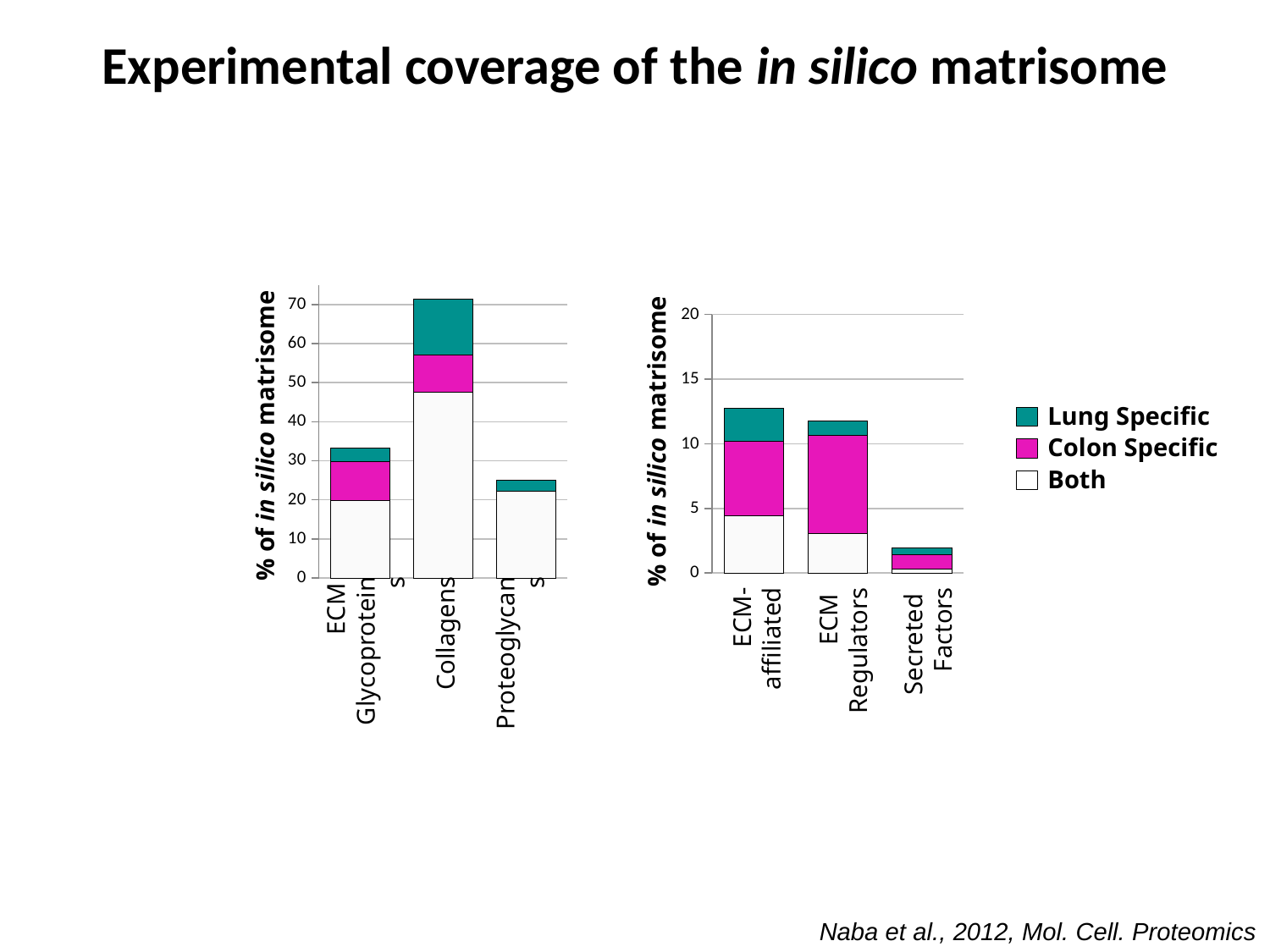
In the left chart, is the total bar for Collagens larger or smaller than the total bar for ECM Glycoproteins? larger In the right chart, which category has the lowest total bar? Secreted Factors In the left chart, is the total value for Proteoglycans greater or less than 30? less In the left chart, is the total value for Collagens greater or less than 60? greater In the right chart, is the total value for ECM Regulators greater or less than 10? greater What kind of chart is the left chart on the slide? stacked bar chart How many categories are shown on the x axis of the right chart? 3 In the left chart, which category has the lowest total bar? Proteoglycans In the left chart, which category has the highest total bar? Collagens How many series does the legend list? 3